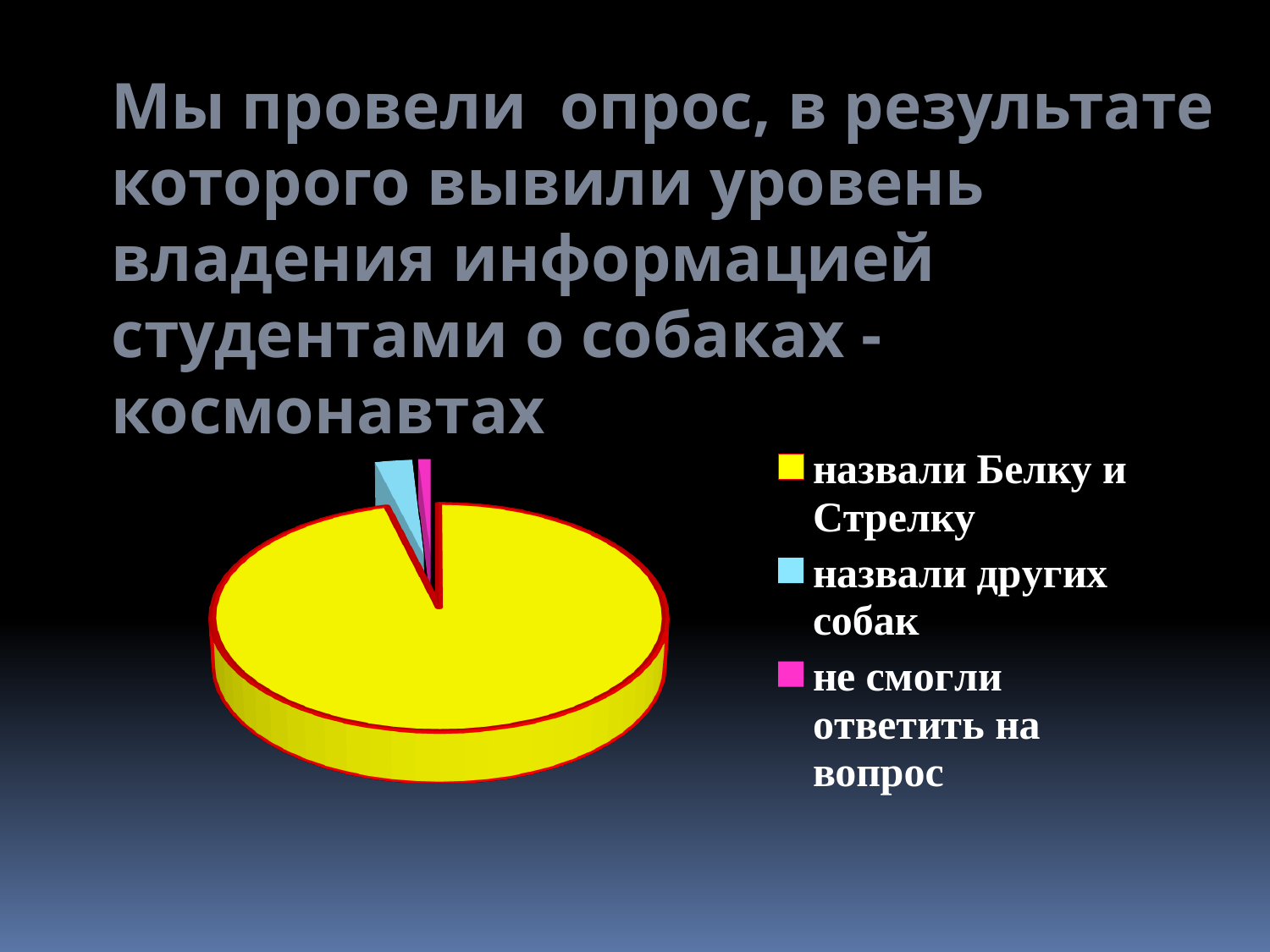
What colour is the slice for "не смогли ответить на вопрос" in the pie chart? magenta (pink) Which category has the largest slice of the pie chart? назвали Белку и Стрелку How many slices does the pie chart have? 3 Which category has the smallest slice of the pie chart? не смогли ответить на вопрос Which slice is larger: "назвали других собак" or "не смогли ответить на вопрос"? назвали других собак Which slice is larger: "назвали Белку и Стрелку" or "назвали других собак"? назвали Белку и Стрелку What colour is the slice for "назвали Белку и Стрелку" in the pie chart? yellow How many entries does the legend of the pie chart list? 3 What kind of chart is shown on the slide? pie chart